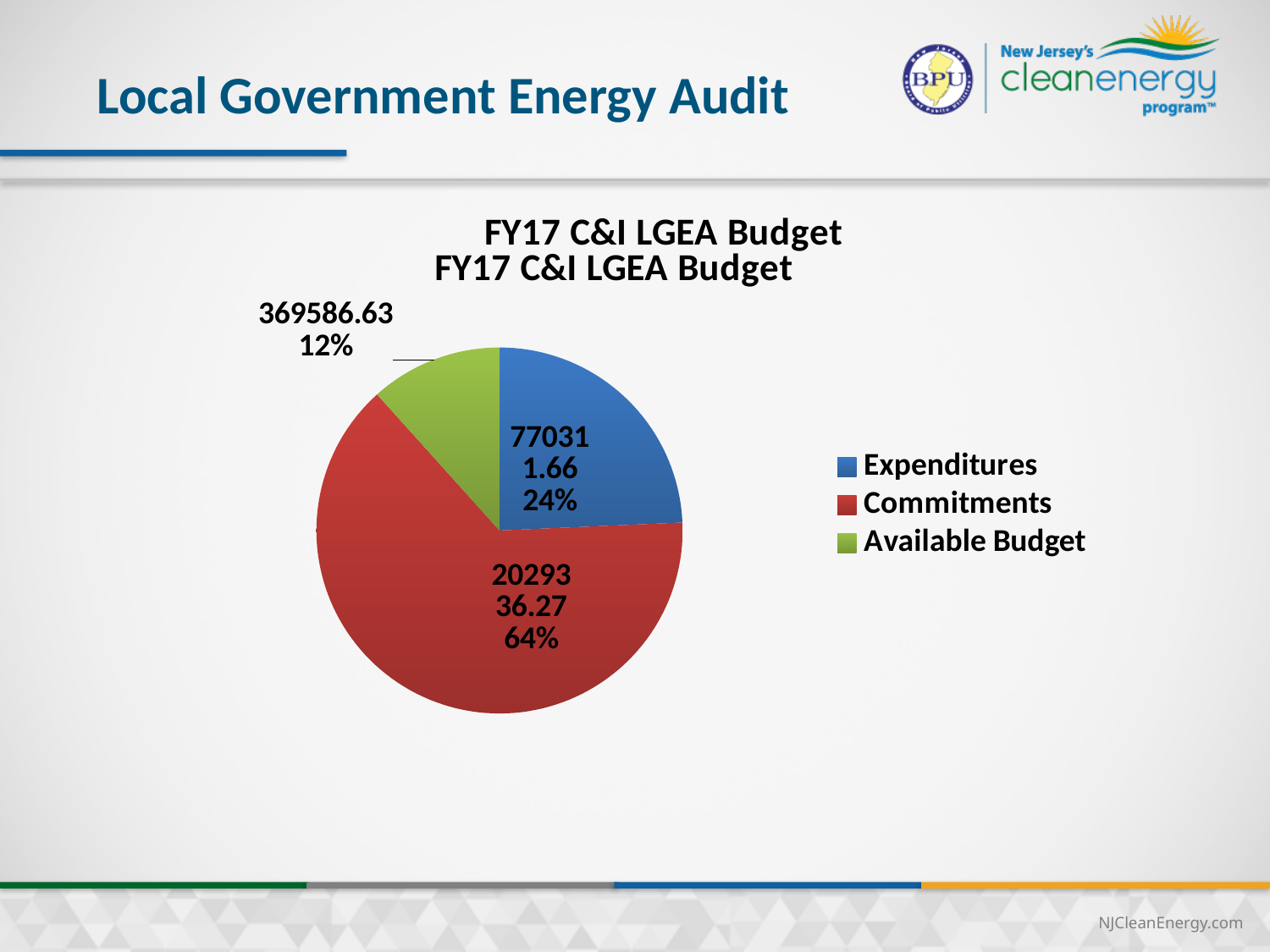
Which category has the largest slice of the pie? Commitments What is the value shown for Available Budget? 369586.63 How many series does the legend list? 3 What percentage share of the pie is Available Budget? 12% How many slices does the pie chart have? 3 What type of chart is shown on the slide? Pie chart What is the value shown for Commitments? 2029336.27 What is the title of the chart? FY17 C&I LGEA Budget What percentage share of the pie is Commitments? 64% What percentage share of the pie is Expenditures? 24% What is the value shown for Expenditures? 770311.66 Which category has the smallest slice of the pie? Available Budget